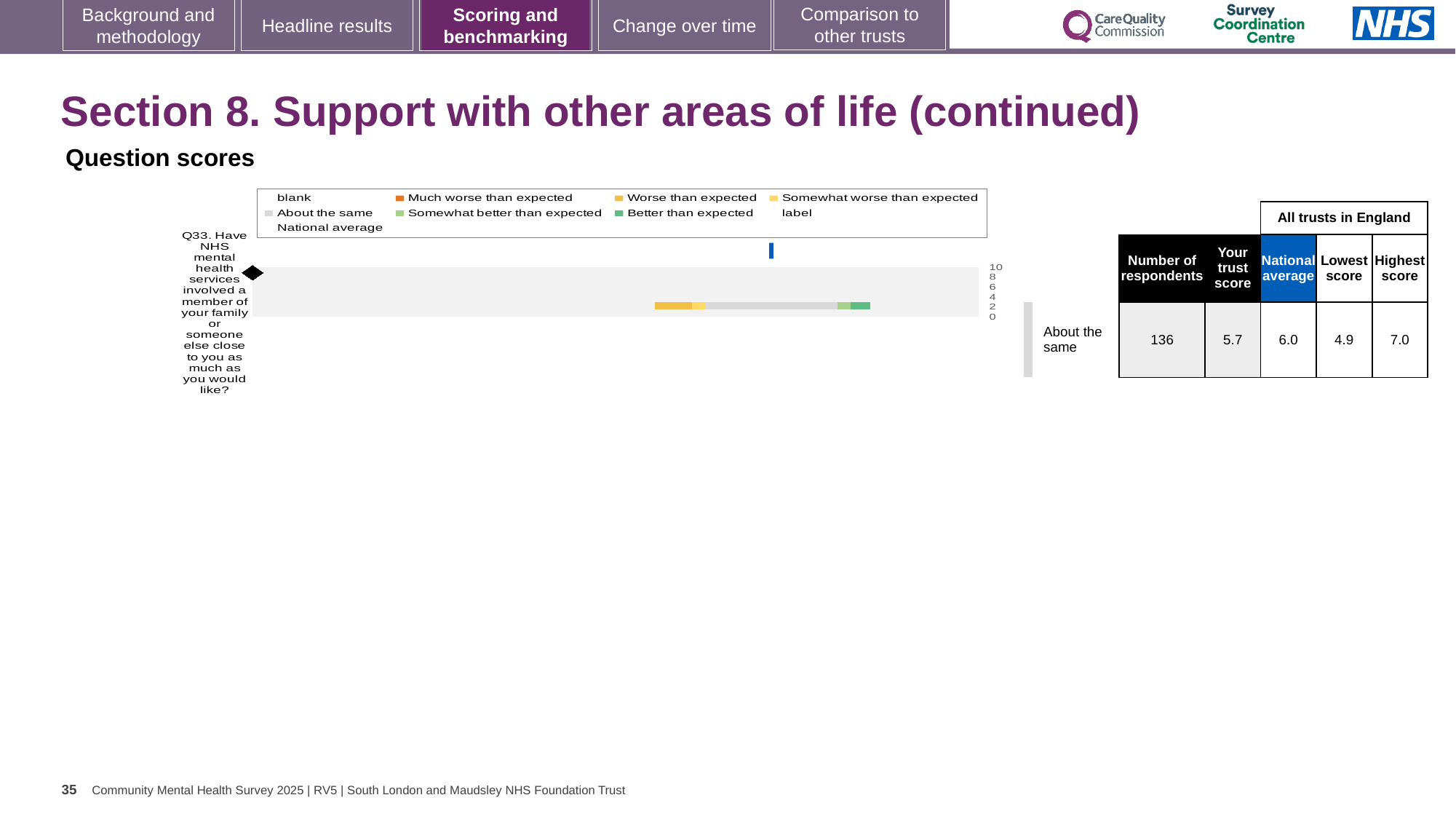
What is the lowest score among all trusts in England for Q33? 4.9 What is the national average score for Q33? 6.0 What is the trust's score for Q33? 5.7 What is the difference between the highest and lowest trust scores for Q33? 2.1 What benchmark category is the trust's Q33 score placed in? About the same Which is larger for Q33, the trust's score or the national average? national average Is the trust's score for Q33 greater or less than 6? less By how much does the national average exceed the trust's score for Q33? 0.3 What kind of chart is used to show the Q33 question score? bar chart What is the number of respondents for Q33? 136 What is the highest score among all trusts in England for Q33? 7.0 How many survey questions are plotted on the chart? 1